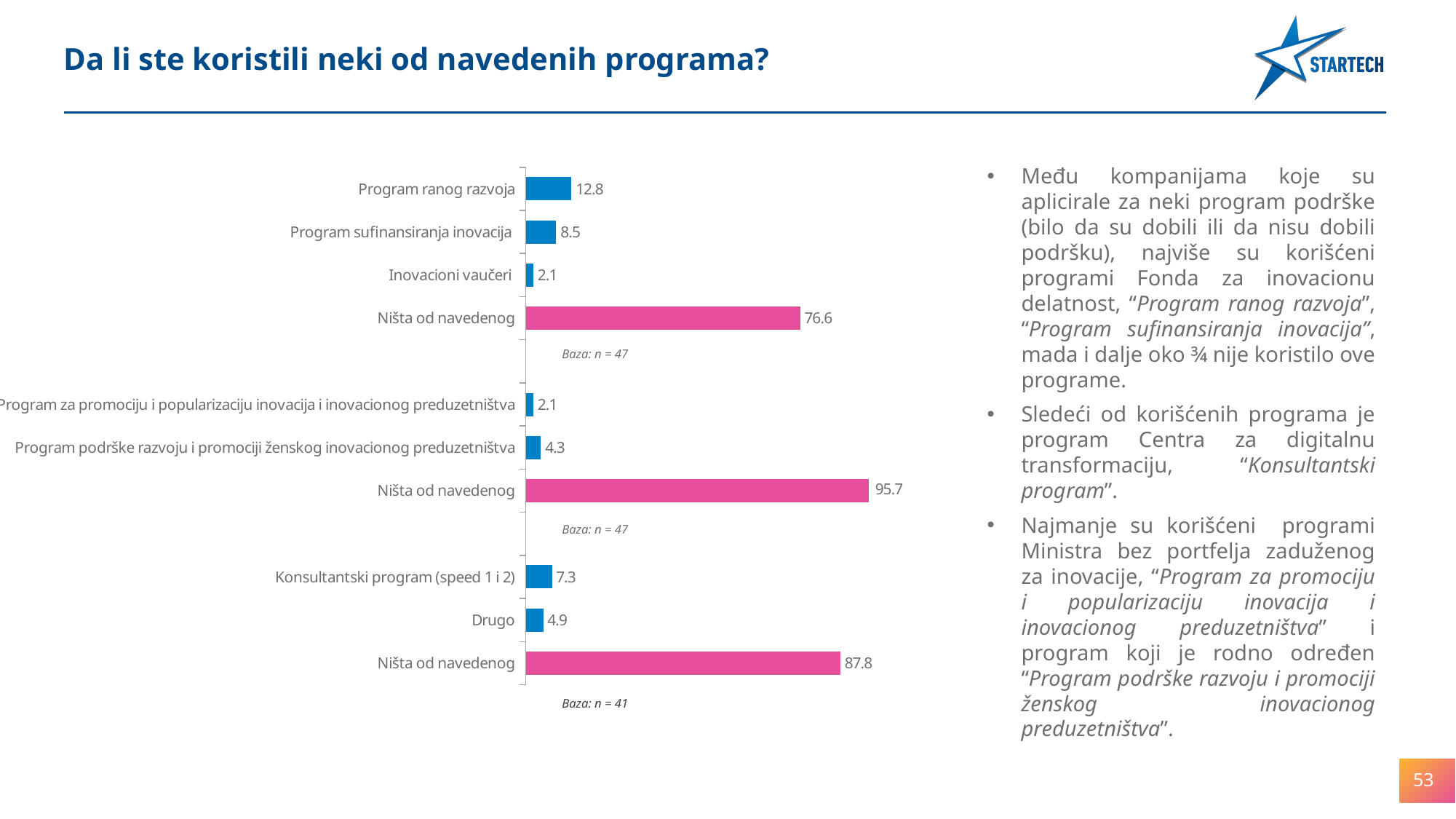
What is the value for "Program sufinansiranja inovacija"? 8.5 Which category has the highest value in the chart? Ništa od navedenog (middle group, 95.7) Which is larger, the value for "Konsultantski program (speed 1 i 2)" or the value for "Drugo"? Konsultantski program (speed 1 i 2) What is the value for "Program podrške razvoju i promociji ženskog inovacionog preduzetništva"? 4.3 What type of chart is shown on the slide? bar chart What is the difference between the values for "Program ranog razvoja" and "Program sufinansiranja inovacija"? 4.3 What is the value for "Konsultantski program (speed 1 i 2)"? 7.3 Which of the three "Ništa od navedenog" bars has the lowest value? The top one (76.6) How many bars are plotted in the chart? 10 What is the value for "Program ranog razvoja"? 12.8 What is the base (Baza) shown under the bottom group of bars? n = 41 What is the value of the "Ništa od navedenog" bar in the middle group (the one with "Program za promociju i popularizaciju inovacija i inovacionog preduzetništva")? 95.7